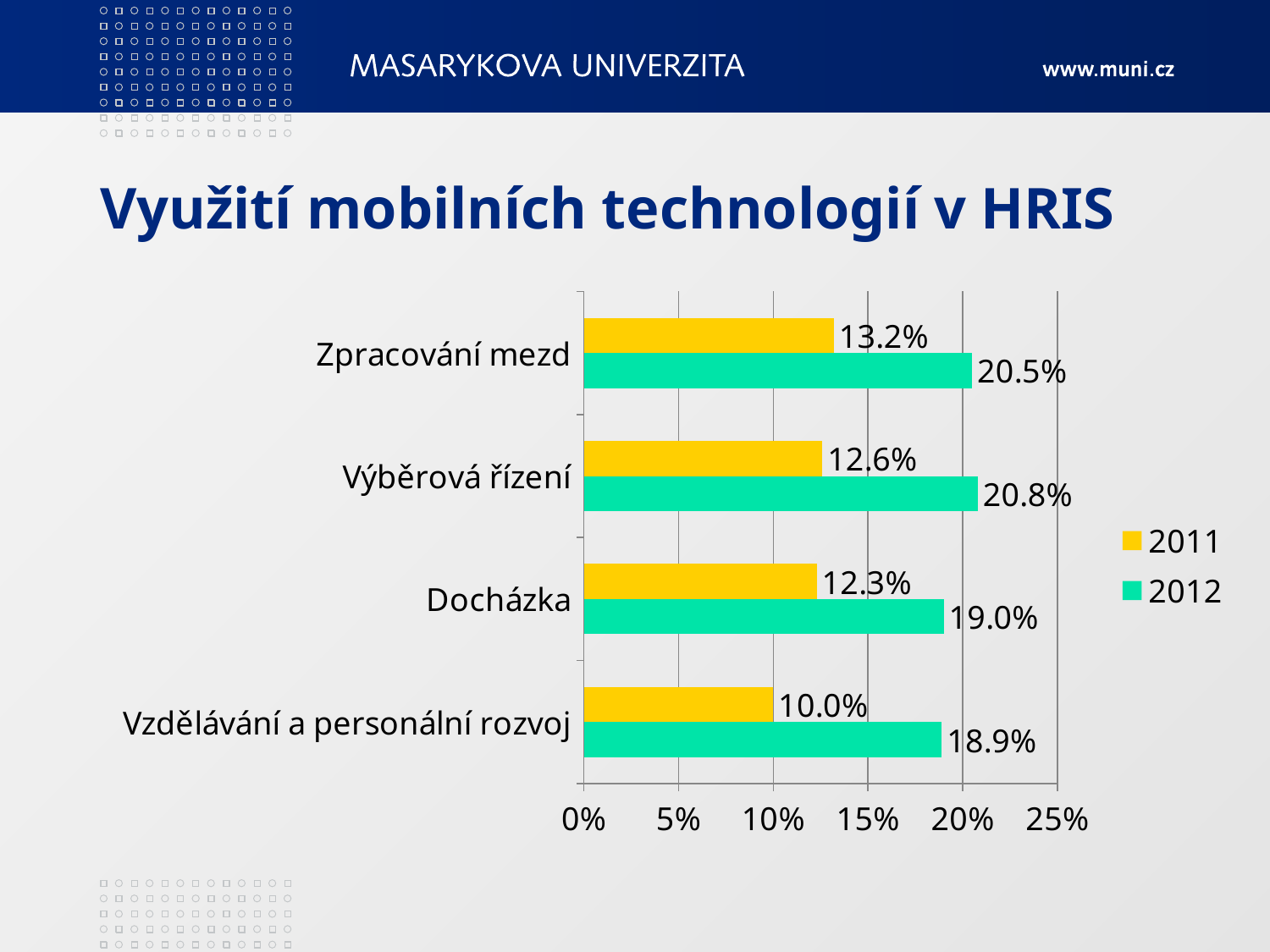
What is the 2011 value for Vzdělávání a personální rozvoj? 10.0% What is the 2012 value for Zpracování mezd? 20.5% Which is larger for Výběrová řízení, the 2011 value or the 2012 value? 2012 Which category has the highest 2012 value? Výběrová řízení Is the 2012 value for Docházka greater or less than 15%? greater What is the difference between the 2012 and 2011 values for Vzdělávání a personální rozvoj? 8.9% Which colour represents the 2011 series in the legend? yellow How many series does the legend list? 2 Which category has the lowest 2011 value? Vzdělávání a personální rozvoj How many categories are shown on the chart? 4 What is the 2011 value for Docházka? 12.3% What kind of chart is shown on the slide? bar chart